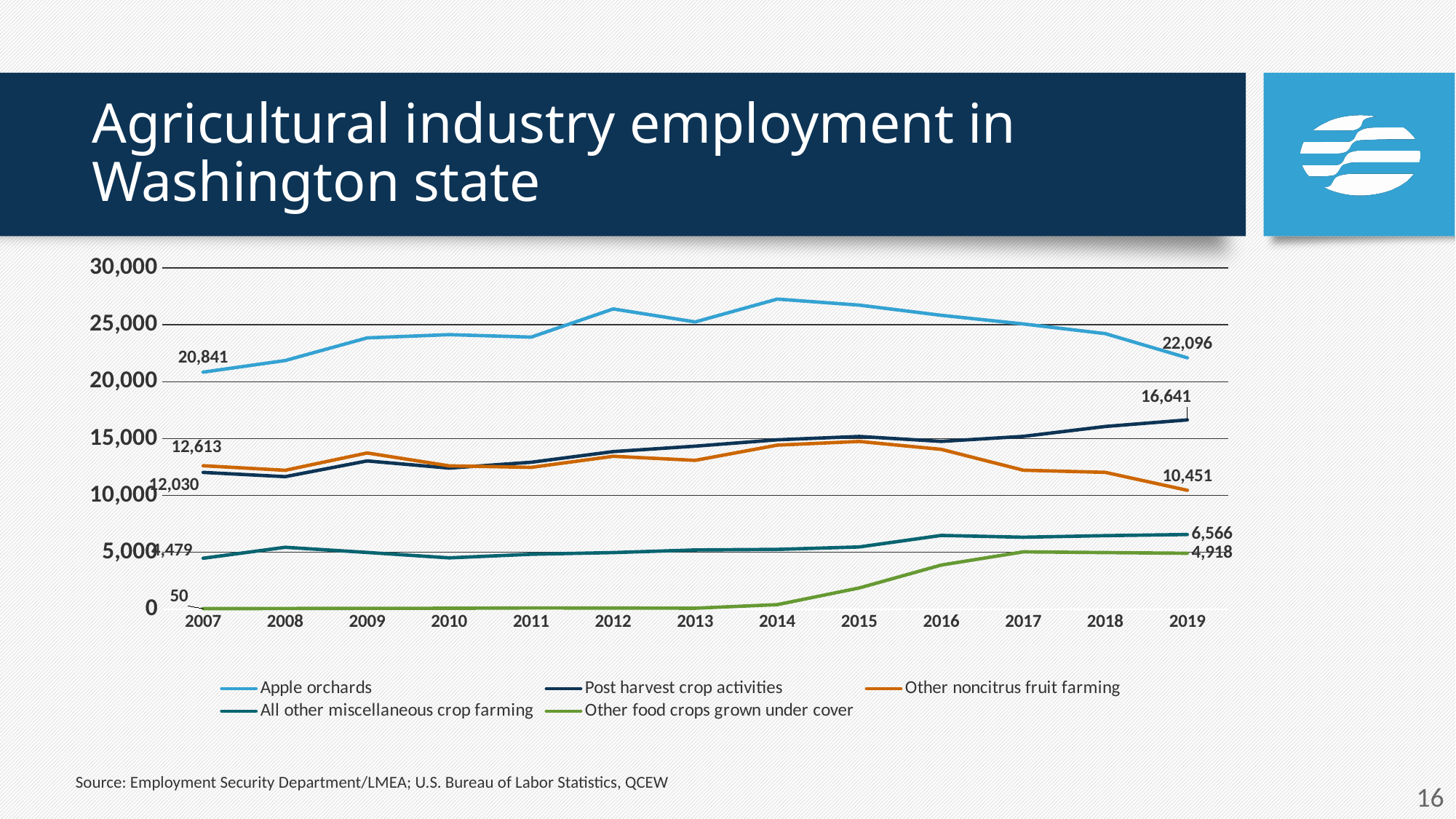
In 2019, which is larger: Post harvest crop activities or Other noncitrus fruit farming? Post harvest crop activities What kind of chart is shown on the slide? line chart What is the difference between Post harvest crop activities in 2019 and in 2007? 4,611 Is the value for Apple orchards in 2014 greater or less than 25,000? greater What is the value for Other food crops grown under cover in 2007? 50 What is the value for Other noncitrus fruit farming in 2007? 12,613 What is the value for Apple orchards in 2019? 22,096 How many series does the legend list? 5 Which series has the highest value in 2019? Apple orchards What is the value for Post harvest crop activities in 2019? 16,641 How many years are plotted along the x axis? 13 By how much did Apple orchards employment change from 2007 (20,841) to 2019 (22,096)? 1,255